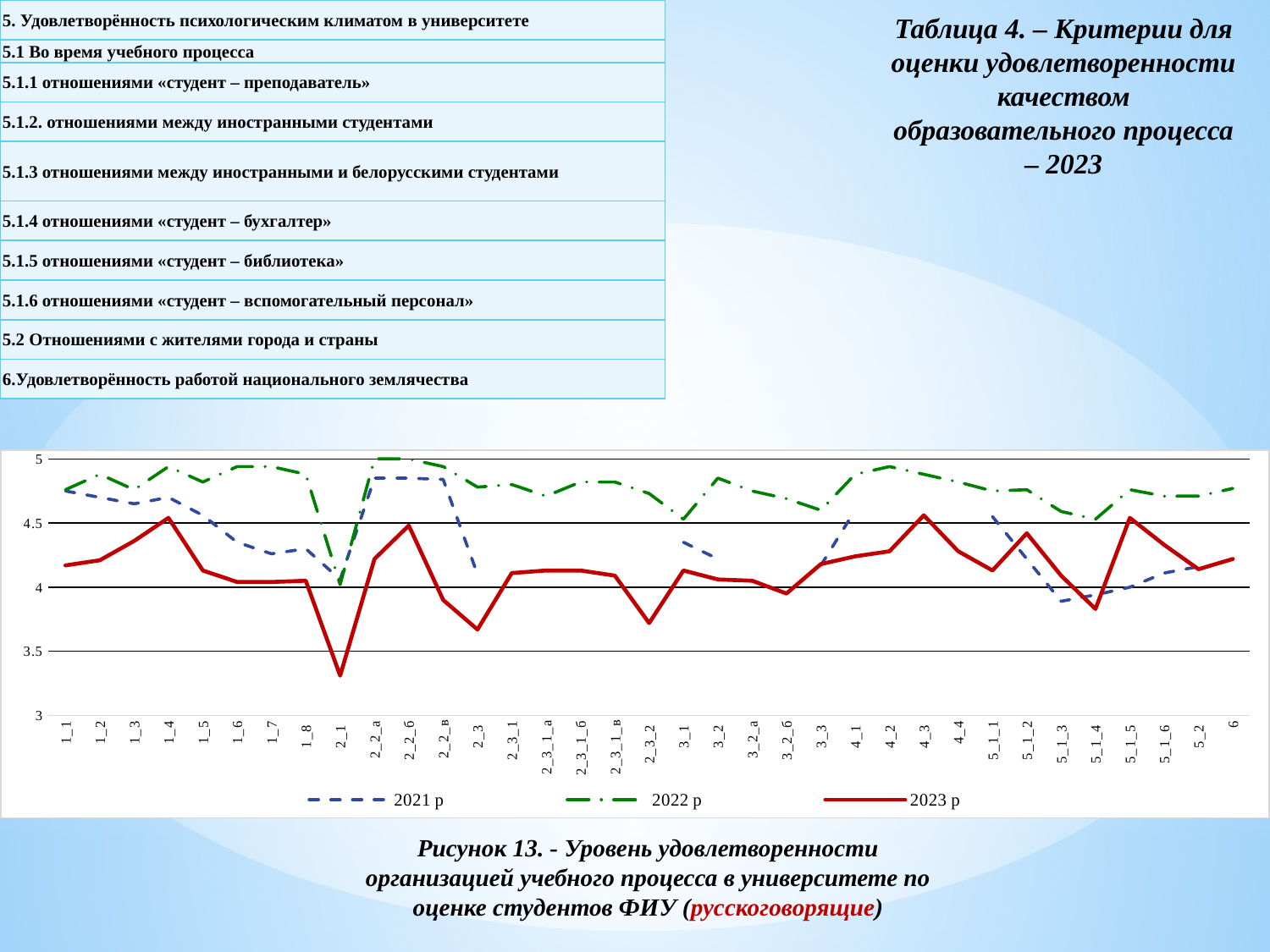
Is the value for 2021 р at category 5_1_4 greater or less than 4? less At category 1_1, which series has the larger value, 2021 р or 2023 р? 2021 р How many categories are plotted along the x axis of the chart? 35 Which category has the lowest value for the 2023 р series? 2_1 Is the value for 2023 р at category 2_3 greater or less than 4? less What colour is the line for the 2023 р series? red At category 2_1, which series has the larger value, 2022 р or 2023 р? 2022 р Is the value for 2022 р at category 2_2_а greater or less than 4.5? greater How many series does the chart legend list? 3 What kind of chart is shown on the slide? line chart Does the 2023 р series rise or fall from category 1_1 to category 1_4? rise